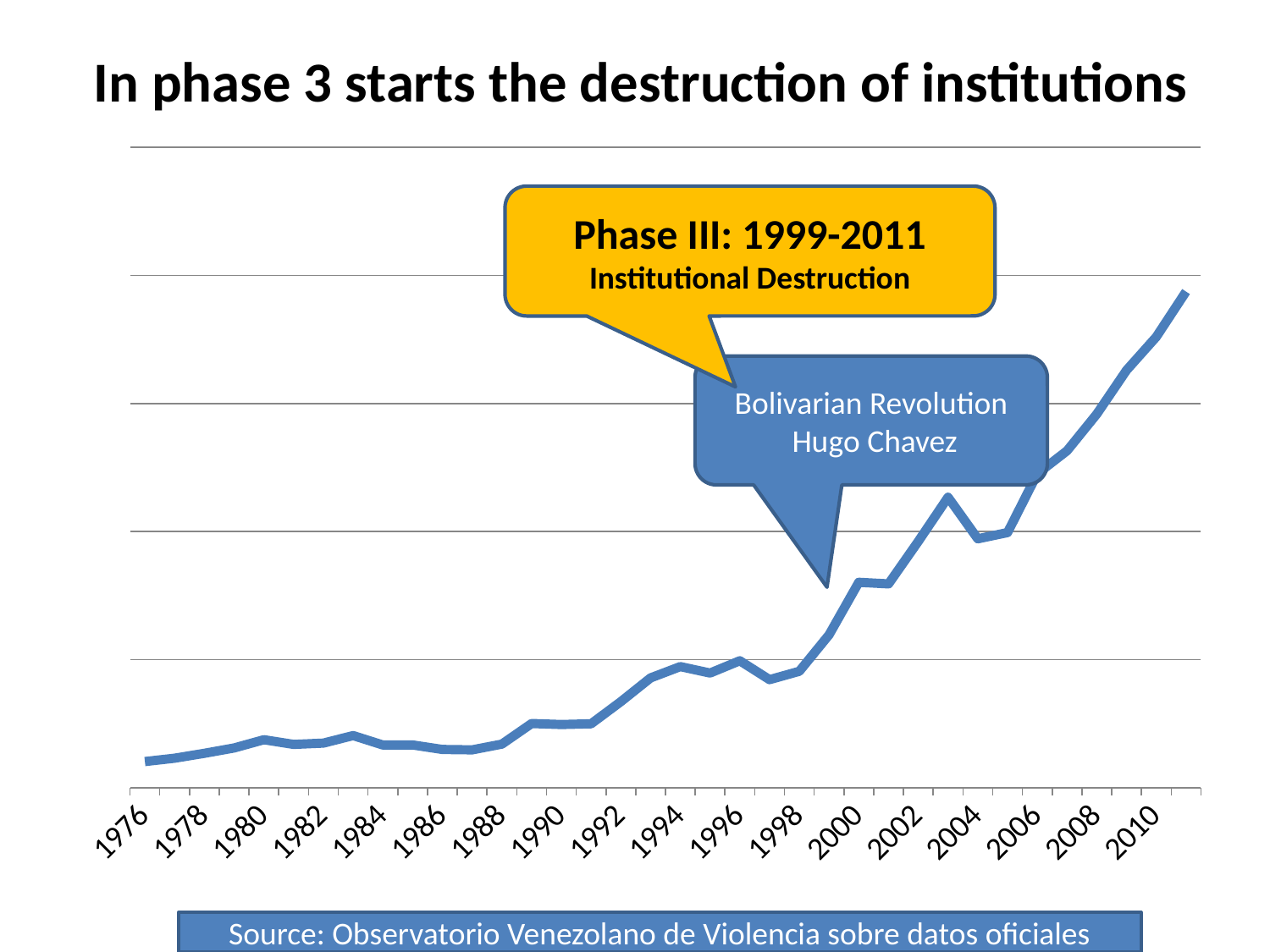
Does the plotted value generally rise or fall from 1976 to the end of the series? rise How many year labels are shown on the x axis? 18 Is the highest point of the line at the beginning or at the end of the series? end Which year has the lowest value on the line? 1976 What kind of chart is shown on the slide? line chart Which year has the larger value, 1980 or 2000? 2000 Which year has the larger value, 2003 or 2004? 2003 How many lines are plotted on the chart? 1 What period does the yellow callout on the chart give for Phase III? 1999-2011 Which year has the larger value, 1990 or 1994? 1994 What source is cited below the chart? Observatorio Venezolano de Violencia sobre datos oficiales